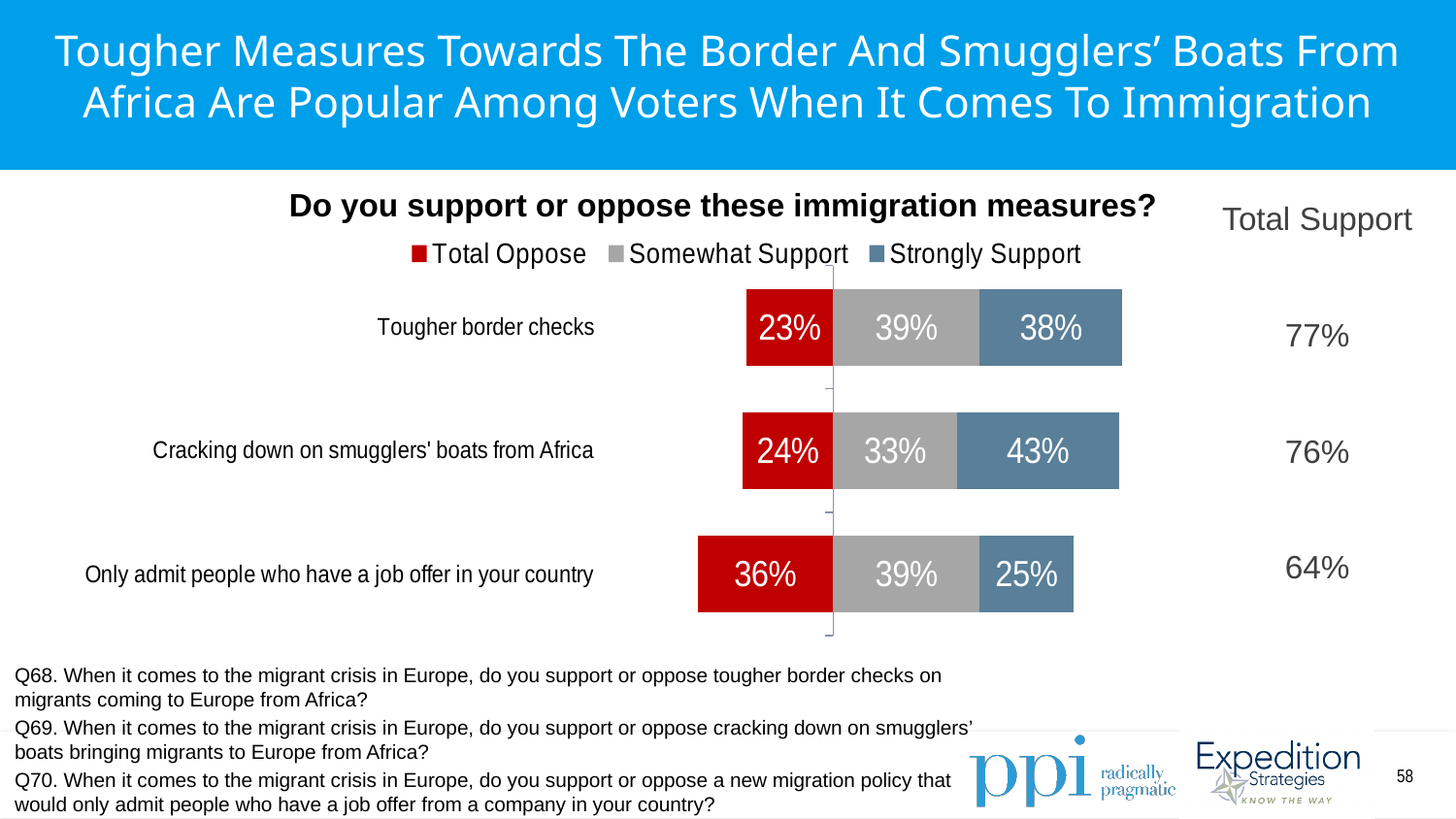
Which measure has the highest Total Oppose value? Only admit people who have a job offer in your country How many series does the legend list? 3 What is the difference between the Strongly Support values for 'Cracking down on smugglers' boats from Africa' and 'Only admit people who have a job offer in your country'? 18% What is the Somewhat Support value for 'Cracking down on smugglers' boats from Africa'? 33% What is the Total Support shown for 'Cracking down on smugglers' boats from Africa'? 76% What is the Total Oppose value for 'Only admit people who have a job offer in your country'? 36% How many immigration measures are shown in the chart? 3 What percentage of voters strongly support tougher border checks? 38% Is the Strongly Support value larger for 'Tougher border checks' or for 'Only admit people who have a job offer in your country'? Tougher border checks What kind of chart is shown on the slide? Stacked bar chart Which measure has the lowest Strongly Support value? Only admit people who have a job offer in your country Which measure has the highest Strongly Support value? Cracking down on smugglers' boats from Africa